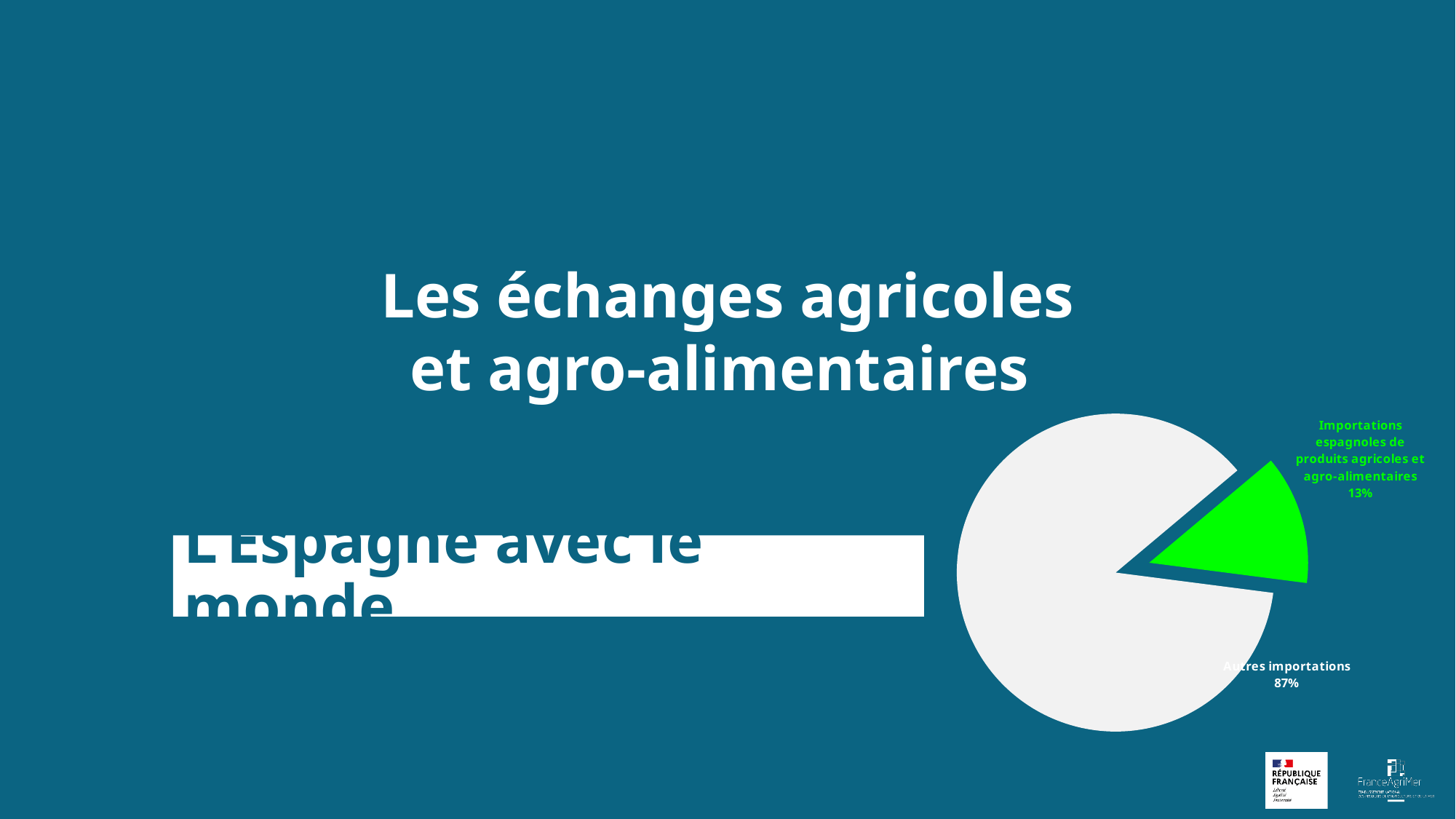
What share of the pie is labelled "Autres importations"? 87% What colour is the slice for "Autres importations"? Light grey What is the difference in percentage points between "Autres importations" and "Importations espagnoles de produits agricoles et agro-alimentaires"? 74 percentage points What is the total of the two percentages shown on the pie chart? 100% What colour is the slice for "Importations espagnoles de produits agricoles et agro-alimentaires"? Green What kind of chart is shown on the slide? Pie chart How many slices does the pie chart have? 2 Which is larger: the share for "Autres importations" or the share for "Importations espagnoles de produits agricoles et agro-alimentaires"? Autres importations Which slice of the pie chart is the largest? Autres importations Which slice of the pie chart is the smallest? Importations espagnoles de produits agricoles et agro-alimentaires What share of the pie is labelled "Importations espagnoles de produits agricoles et agro-alimentaires"? 13%